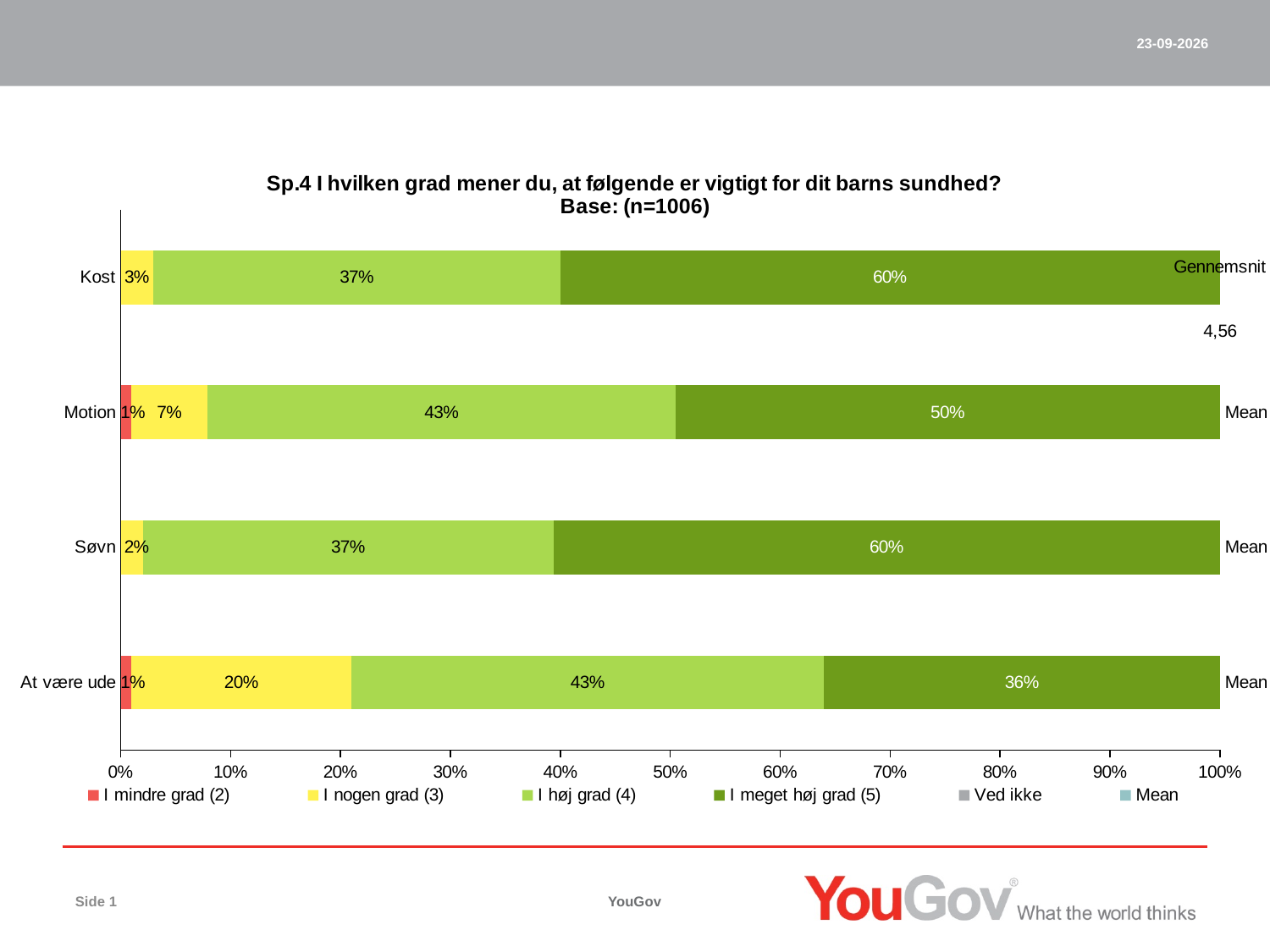
How many entries does the legend list? 6 Which category has the highest value for 'I nogen grad (3)'? At være ude What is the difference between the 'I meget høj grad (5)' values for Motion and At være ude? 14 percentage points What is the value for 'I høj grad (4)' for Motion? 43% What is the Gennemsnit (mean) shown for Kost? 4,56 What is the value for 'I meget høj grad (5)' for Søvn? 60% How many categories are shown on the y axis of the chart? 4 What kind of chart is shown on the slide? Stacked bar chart Which category has the lowest value for 'I meget høj grad (5)'? At være ude What is the value for 'I nogen grad (3)' for At være ude? 20% Which is larger: the 'I høj grad (4)' value for Motion or for Kost? Motion What is the value for 'I meget høj grad (5)' for Kost? 60%